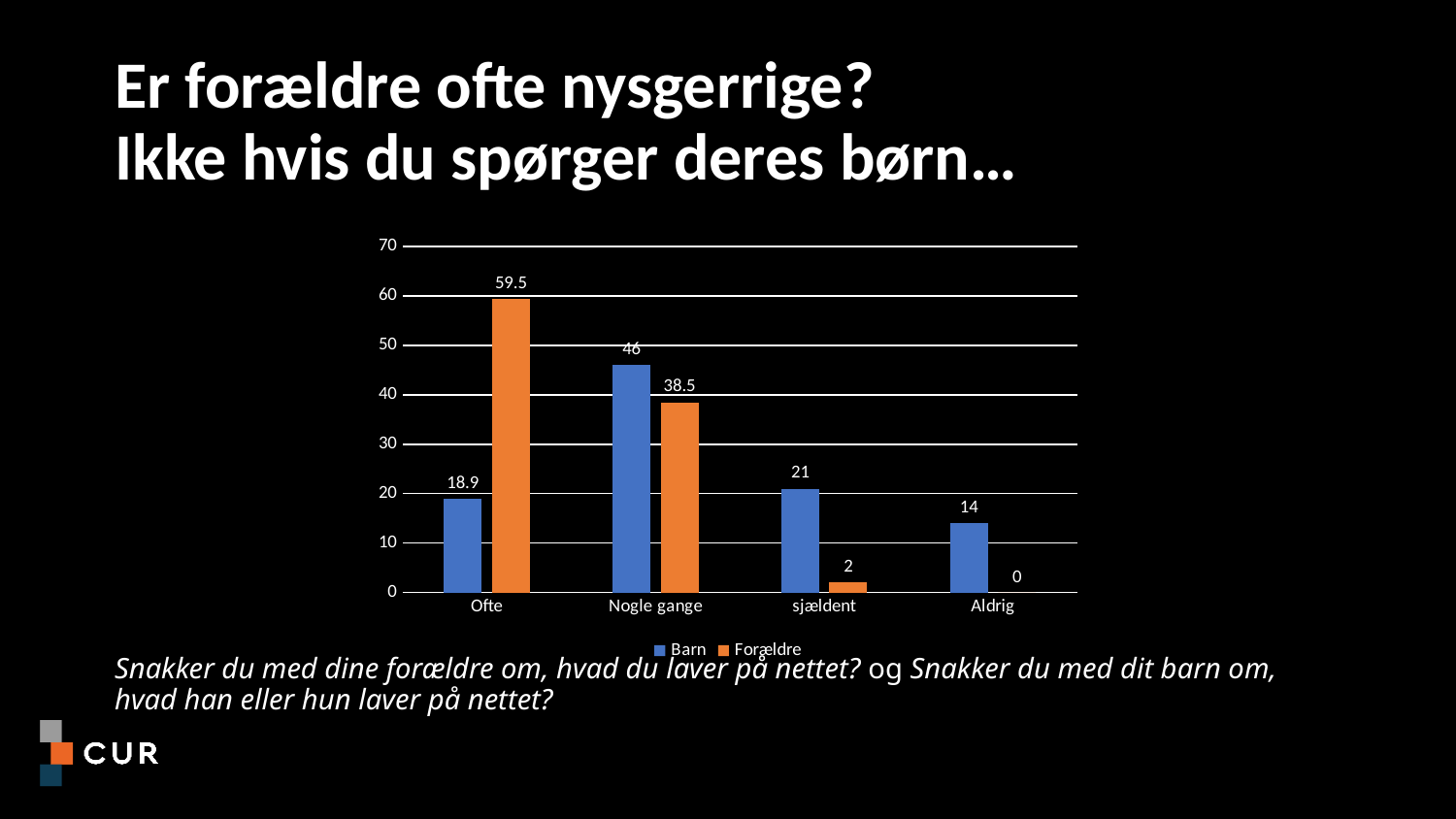
How many categories are shown on the x axis? 4 What is the difference between the Forældre and Barn values in the Ofte category? 40.6 Which category has the lowest value for the Forældre series? Aldrig What is the value for Forældre in the Nogle gange category? 38.5 Which category has the highest value for the Barn series? Nogle gange What is the value for Forældre in the Ofte category? 59.5 How many series does the legend list? 2 Which is larger in the sjældent category, Barn or Forældre? Barn What kind of chart is shown on the slide? Bar chart What is the value for Barn in the Aldrig category? 14 What is the value for Barn in the Ofte category? 18.9 What colour are the bars for the Forældre series? Orange